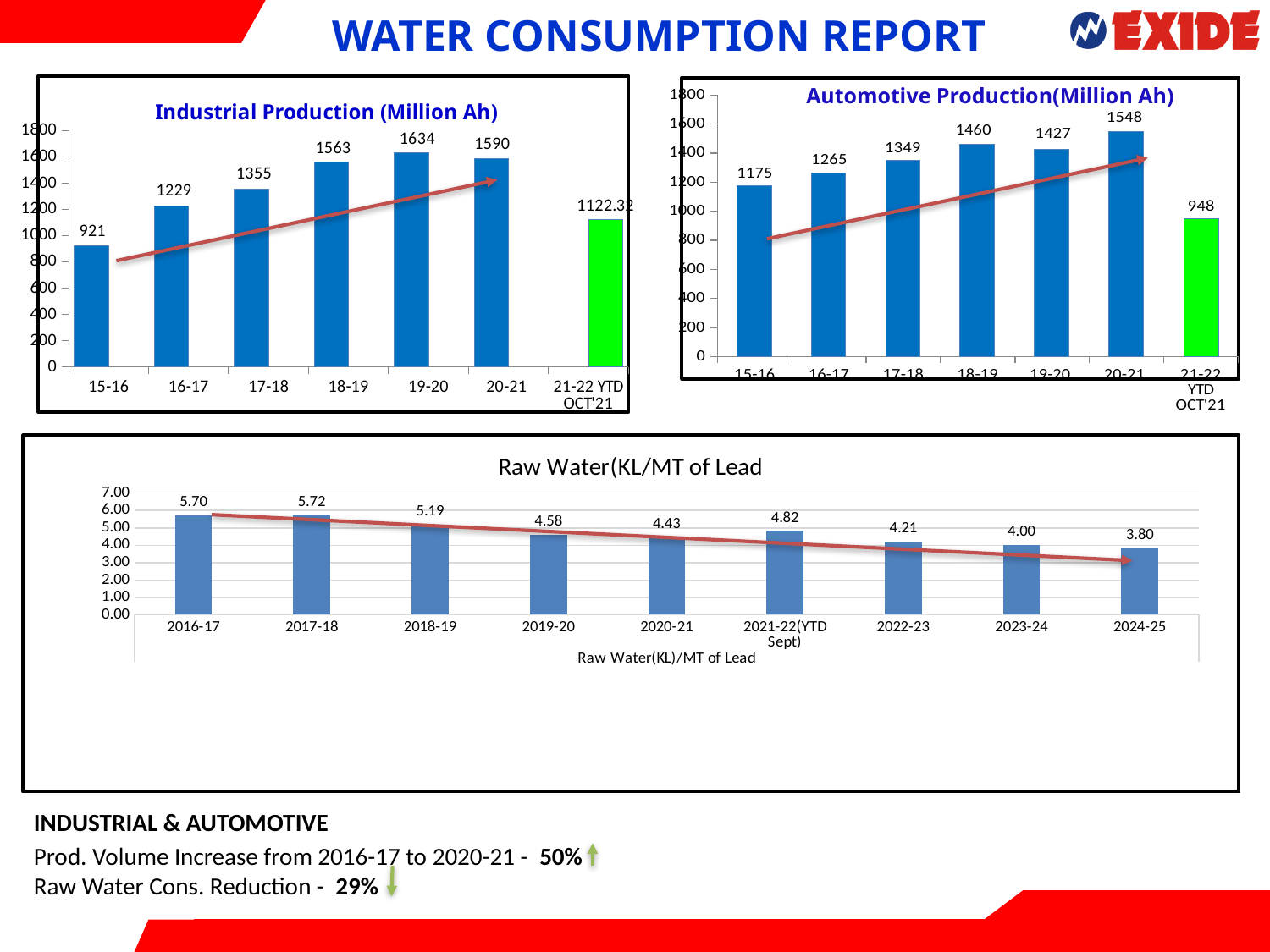
In the Raw Water(KL/MT of Lead chart, what is the value for 2019-20? 4.58 In the Industrial Production (Million Ah) chart, what is the difference between the values for 20-21 and 15-16? 669 In the Raw Water(KL/MT of Lead chart, which category has the highest value? 2017-18 In the Automotive Production(Million Ah) chart, which is larger, the value for 18-19 or the value for 19-20? 18-19 In the Industrial Production (Million Ah) chart, which category has the highest value? 19-20 In the Industrial Production (Million Ah) chart, how many bars are plotted? 7 In the Automotive Production(Million Ah) chart, what is the difference between the values for 20-21 and 19-20? 121 In the Industrial Production (Million Ah) chart, what is the value for 18-19? 1563 What kind of chart is the Raw Water(KL/MT of Lead chart? bar chart In the Automotive Production(Million Ah) chart, what is the value for 17-18? 1349 In the Automotive Production(Million Ah) chart, which category has the lowest value? 21-22 YTD OCT'21 In the Raw Water(KL/MT of Lead chart, do the values generally rise or fall from 2016-17 to 2024-25? fall